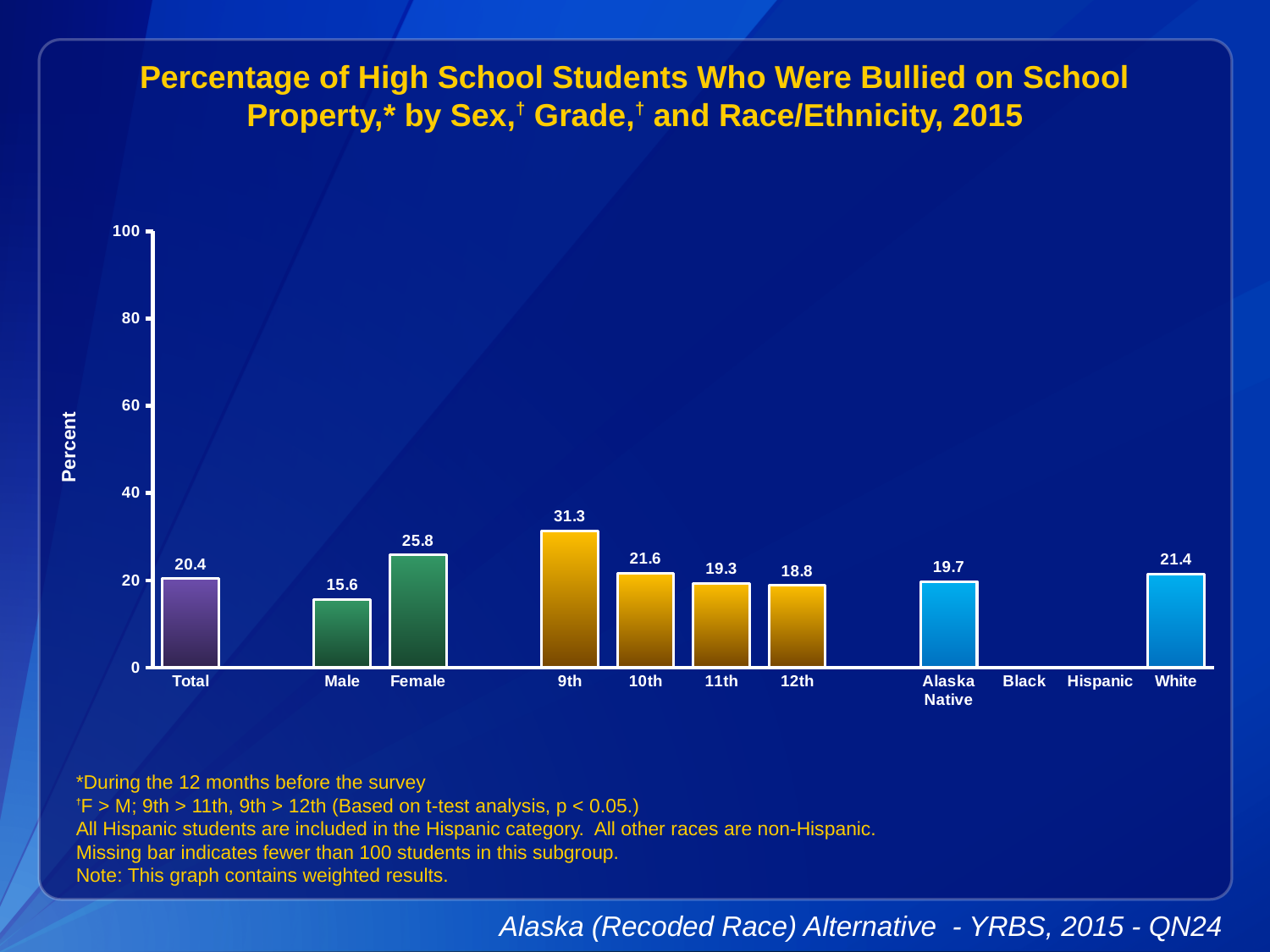
Is the value for 9th grade greater or less than 40? less Which category has the highest value? 9th What is the value for Female? 25.8 What kind of chart is shown? bar chart What is the value for Alaska Native? 19.7 Which is larger, the value for White or the value for Alaska Native? White What is the difference between the 9th and 12th grade values? 12.5 What is the value for Total? 20.4 Do the values fall or rise from 9th grade to 12th grade? fall What is the difference between the Female and Male values? 10.2 Which category with a plotted bar has the lowest value? Male What is the value for 9th grade? 31.3